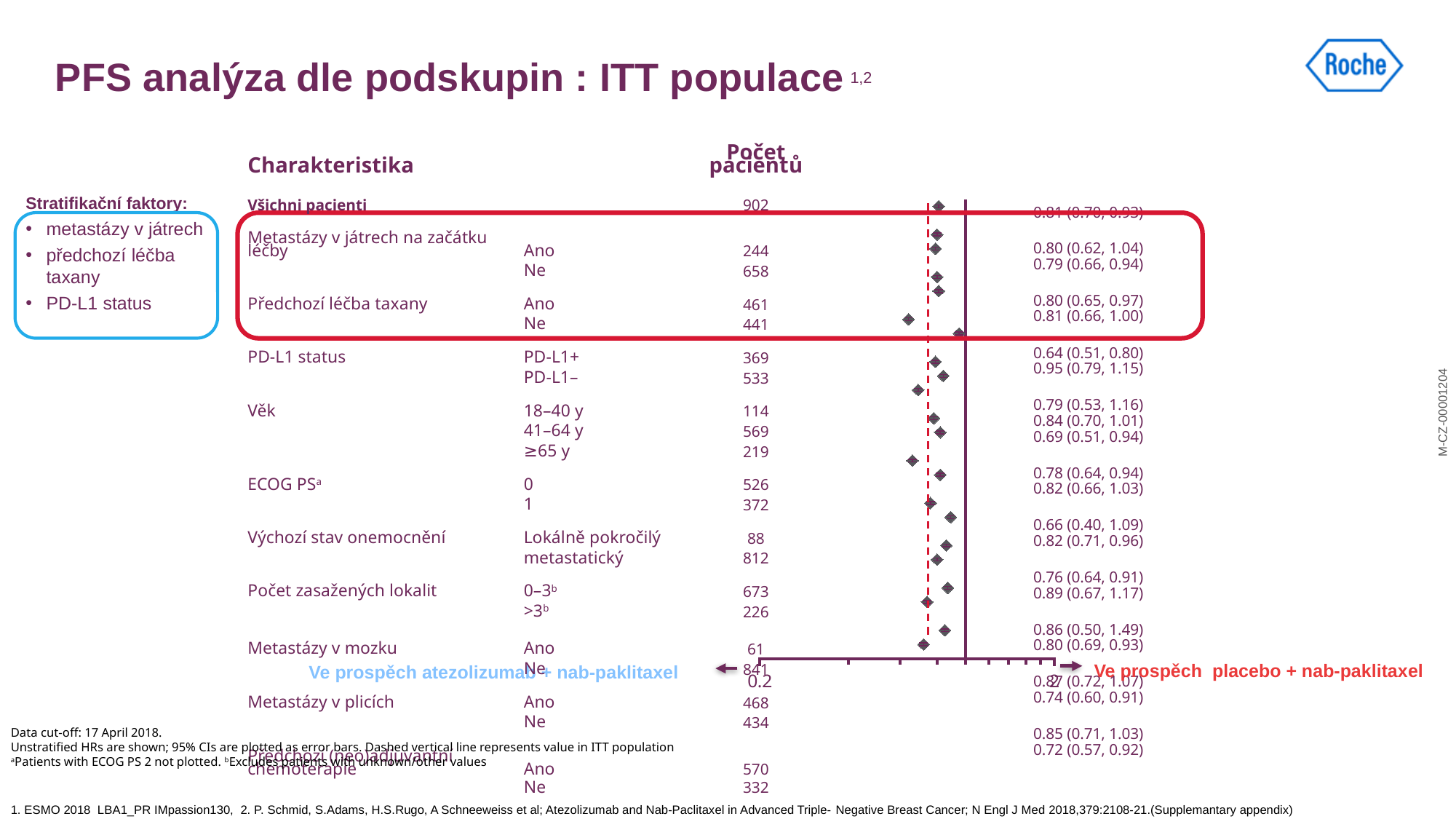
How many patients are in the PD-L1+ subgroup? 369 What is the lowest value printed on the horizontal axis of the forest plot? 0.2 What is the hazard ratio (95% CI) shown for the PD-L1– subgroup? 0.95 (0.79, 1.15) What is the hazard ratio (95% CI) shown for the PD-L1+ subgroup? 0.64 (0.51, 0.80) Which has more patients: the 'Předchozí léčba taxany – Ano' subgroup or the 'Předchozí léčba taxany – Ne' subgroup? Ano (461) What kind of chart is shown on the slide? Forest plot How many patients are in the 'Všichni pacienti' (all patients) row? 902 Which age subgroup (Věk) has the fewest patients? 18–40 y (114) What is the difference in patient numbers between the PD-L1– (533) and PD-L1+ (369) subgroups? 164 How many patients are in the 'Metastázy v mozku – Ano' subgroup? 61 According to the footnote, what does the dashed vertical line represent? Value in ITT population How many patients had liver metastases at baseline (Metastázy v játrech na začátku léčby – Ano)? 244